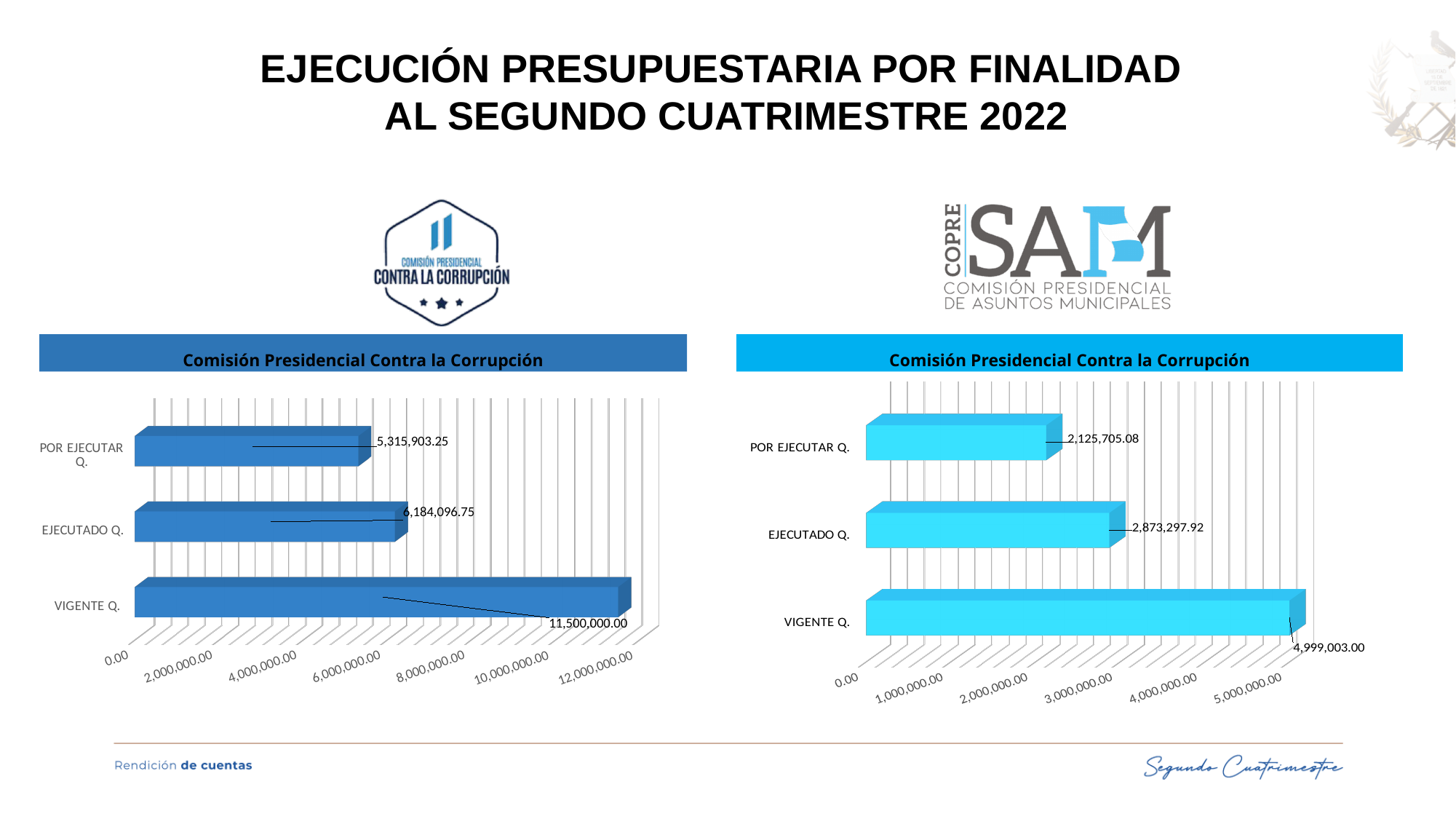
In the right chart, which category has the highest value? VIGENTE Q. In the right chart, what is the value for POR EJECUTAR Q.? 2,125,705.08 In the left chart, which category has the lowest value? POR EJECUTAR Q. In the left chart, what is the difference between EJECUTADO Q. and POR EJECUTAR Q.? 868,193.50 In the right chart, what is the value for VIGENTE Q.? 4,999,003.00 In the right chart, what is the difference between VIGENTE Q. and EJECUTADO Q.? 2,125,705.08 In the left chart, what is the value for VIGENTE Q.? 11,500,000.00 In the left chart, what is the value for EJECUTADO Q.? 6,184,096.75 How many categories does the right chart show? 3 In the left chart, is the value for EJECUTADO Q. greater or less than 8,000,000.00? less In the right chart, which is larger, EJECUTADO Q. or POR EJECUTAR Q.? EJECUTADO Q. What kind of chart is the left chart? Bar chart